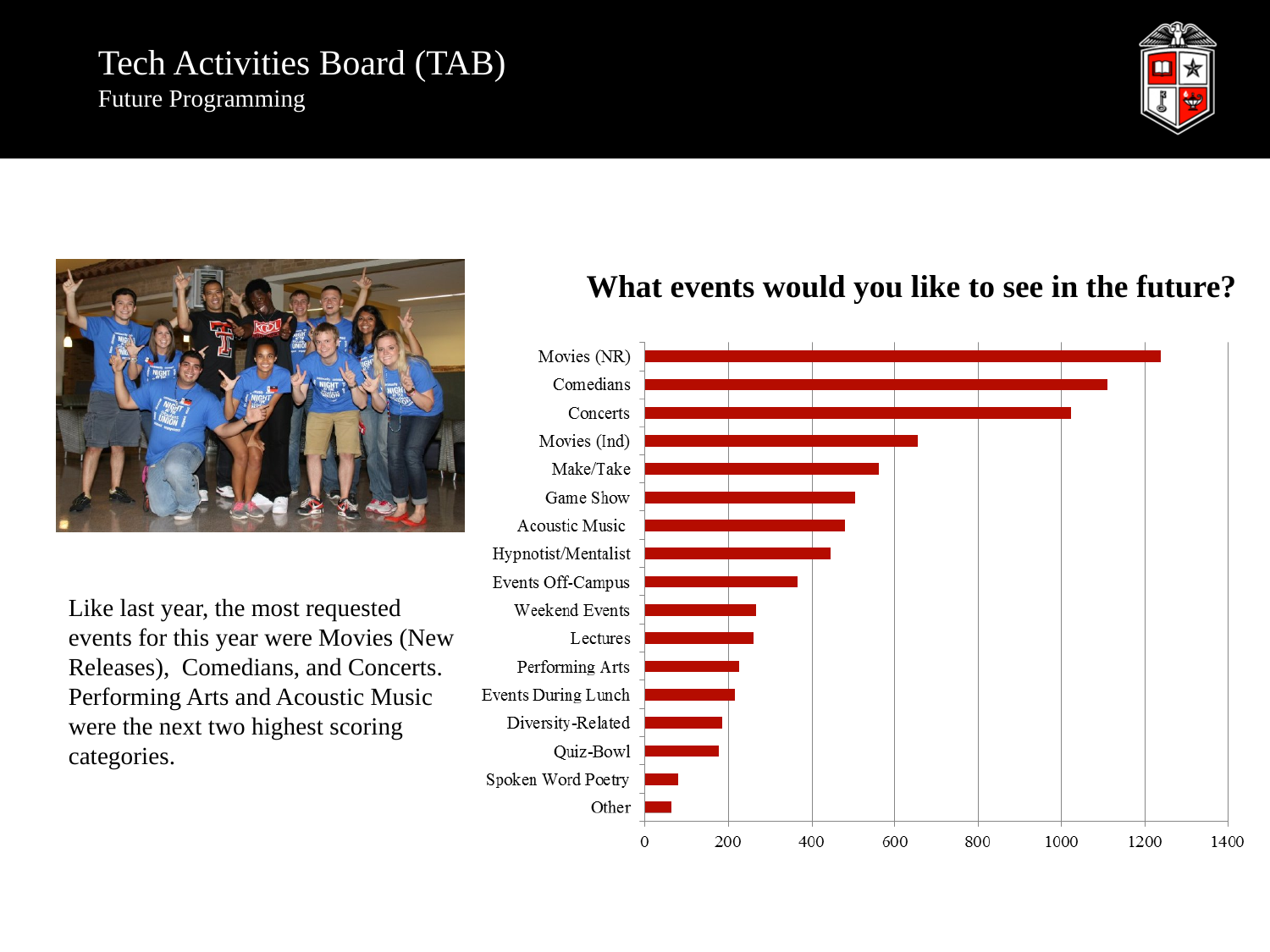
Which event category has the highest value in the chart? Movies (NR) Is the value for Comedians greater or less than 1000? greater Which event category has the lowest value in the chart? Other Is the value for Spoken Word Poetry greater or less than 200? less Is the value for Game Show greater or less than 400? greater What is the title of the chart? What events would you like to see in the future? How many event categories are plotted in the chart? 17 What is the highest value shown on the horizontal axis of the chart? 1400 Which has a larger value, Comedians or Concerts? Comedians Which has a larger value, Movies (Ind) or Make/Take? Movies (Ind) What kind of chart is shown on the slide? Bar chart